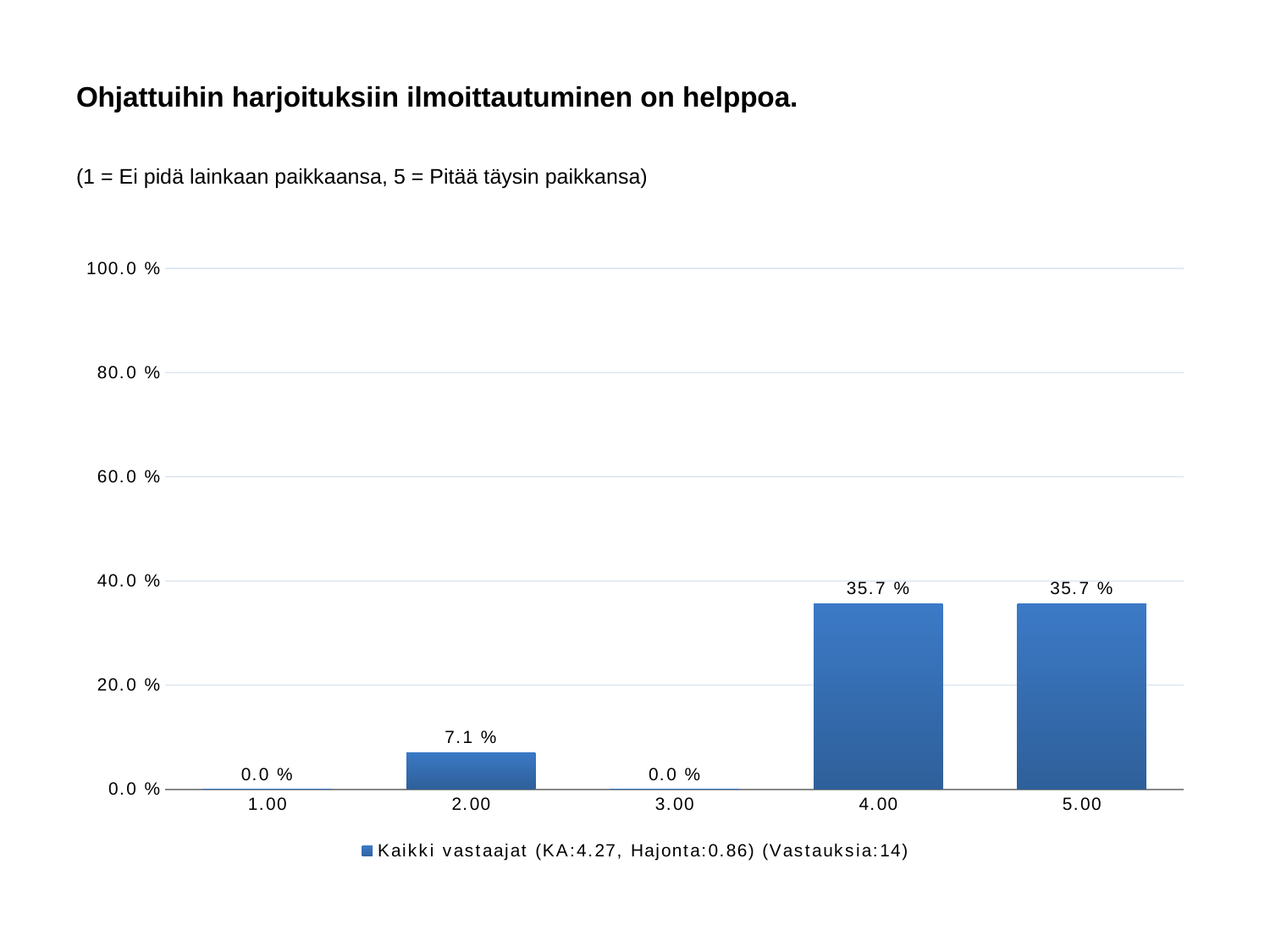
How many responses (Vastauksia) does the legend report? 14 What is the difference between the values for 4.00 and 2.00? 28.6 % Which is larger, the value for 2.00 or the value for 5.00? 5.00 What is the value for category 4.00? 35.7 % How many categories are shown on the x axis? 5 What is the value for category 1.00? 0.0 % Is the value for 4.00 greater or less than 20.0 %? greater How many series does the legend list? 1 Which category has the lowest non-zero value? 2.00 What is the value for category 5.00? 35.7 % What kind of chart is shown? bar chart What is the value for category 2.00? 7.1 %